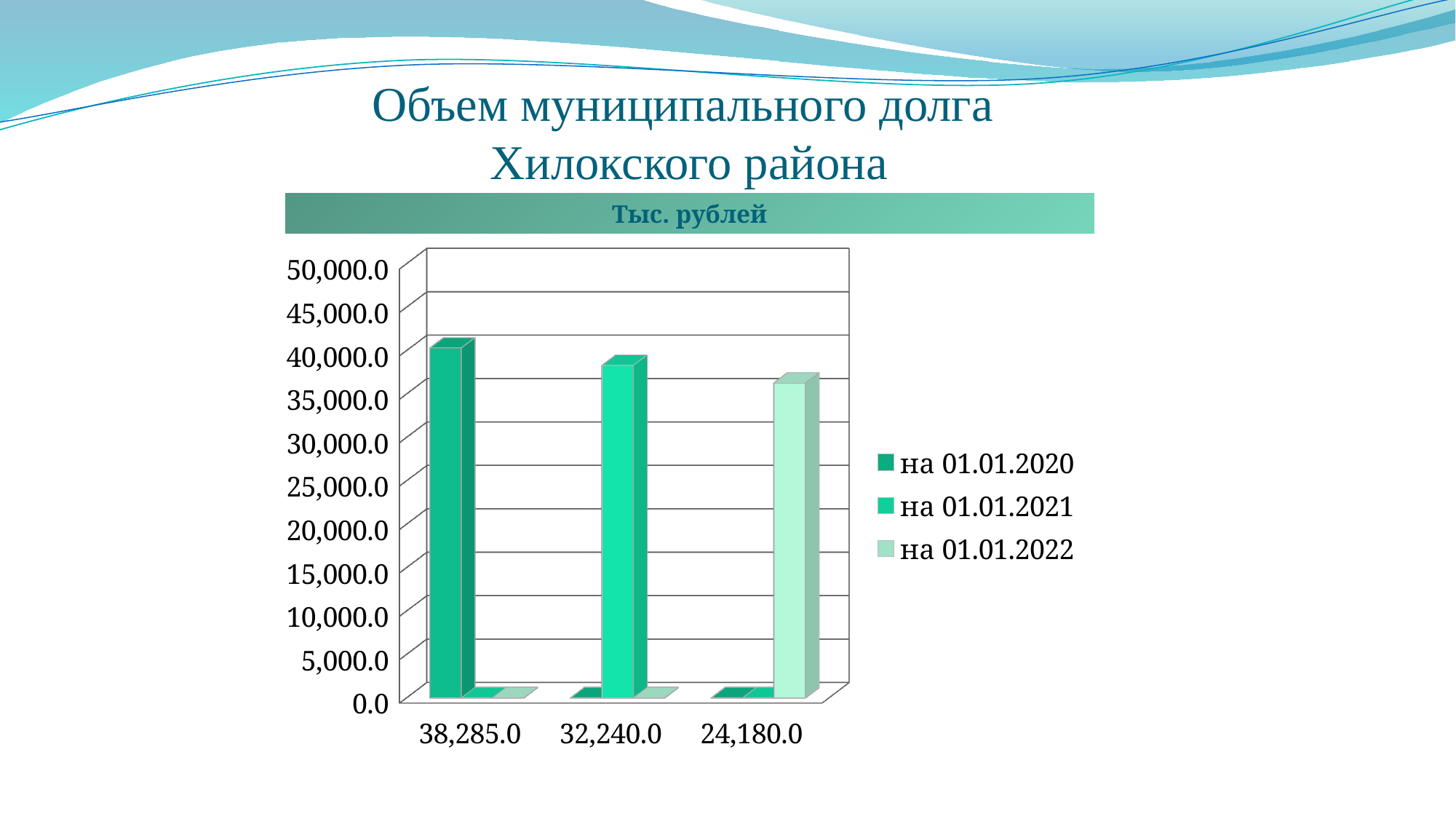
Is the tallest bar for the series на 01.01.2022 greater or less than 40,000.0? less What are the three series listed in the legend? на 01.01.2020, на 01.01.2021, на 01.01.2022 Is the tallest bar for the series на 01.01.2020 greater or less than 45,000.0? less What title is shown above the chart's plot area? Тыс. рублей What kind of chart is shown on the slide? bar chart Is the tallest bar for the series на 01.01.2021 greater or less than 30,000.0? greater Do the tall bars rise or fall moving from left to right across the chart? fall How many category groups are shown along the x axis? 3 Which series has the tallest bar on the chart? на 01.01.2020 How many series does the legend list? 3